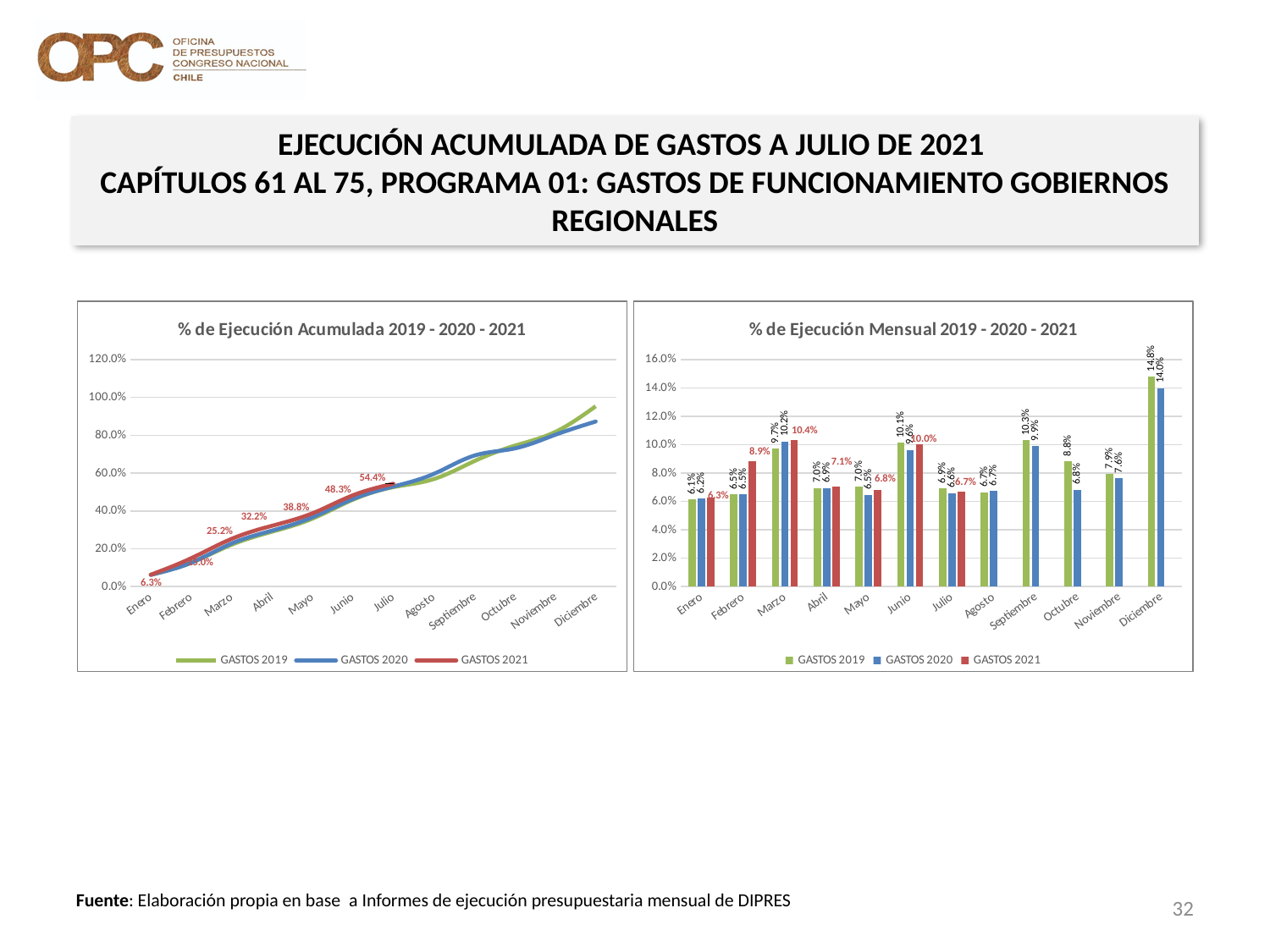
In the left chart '% de Ejecución Acumulada', what is the GASTOS 2021 value for Marzo? 25.2% In the left chart '% de Ejecución Acumulada', what is the difference between the GASTOS 2021 values for Julio and Junio? 6.1% In the right chart '% de Ejecución Mensual', what is the GASTOS 2019 value for Diciembre? 14.8% In the right chart '% de Ejecución Mensual', which month has the highest GASTOS 2020 value? Diciembre In the left chart '% de Ejecución Acumulada', does the GASTOS 2021 line rise or fall from Enero to Julio? Rises In the right chart '% de Ejecución Mensual', what is the GASTOS 2021 value for Febrero? 8.9% In the right chart '% de Ejecución Mensual', what is the difference between the GASTOS 2019 and GASTOS 2020 values for Diciembre? 0.8% In the left chart '% de Ejecución Acumulada', how many series does the legend list? 3 What kind of chart is the right chart titled '% de Ejecución Mensual 2019 - 2020 - 2021'? Bar chart In the right chart '% de Ejecución Mensual', how many months are shown on the x axis? 12 In the left chart '% de Ejecución Acumulada', what is the GASTOS 2021 value for Julio? 54.4% What kind of chart is the left chart titled '% de Ejecución Acumulada 2019 - 2020 - 2021'? Line chart